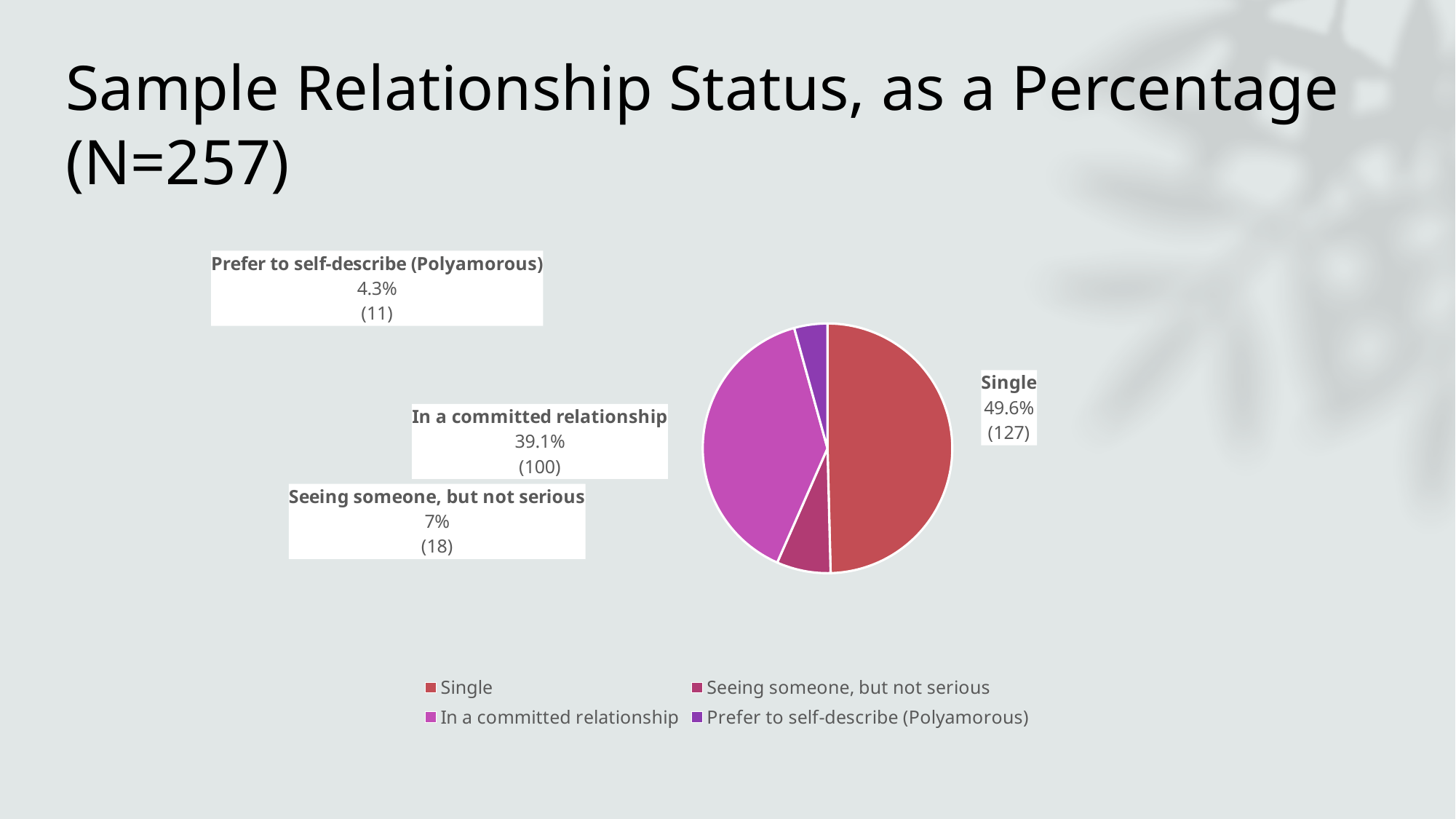
What is the difference in percentage points between Single and Seeing someone, but not serious? 42.6 What is the difference in respondent counts between Single and In a committed relationship? 27 How many respondents are in a committed relationship? 100 What percentage of the sample is seeing someone, but not serious? 7% Which relationship status has the largest share of the pie? Single Which is larger: the share for Seeing someone, but not serious or the share for Prefer to self-describe (Polyamorous)? Seeing someone, but not serious How many relationship status categories does the pie chart show? 4 How many respondents chose Prefer to self-describe (Polyamorous)? 11 Which relationship status has the smallest share of the pie? Prefer to self-describe (Polyamorous) What kind of chart is shown on the slide? pie chart What percentage of the sample is Single? 49.6% What is the total sample size stated in the slide title? 257